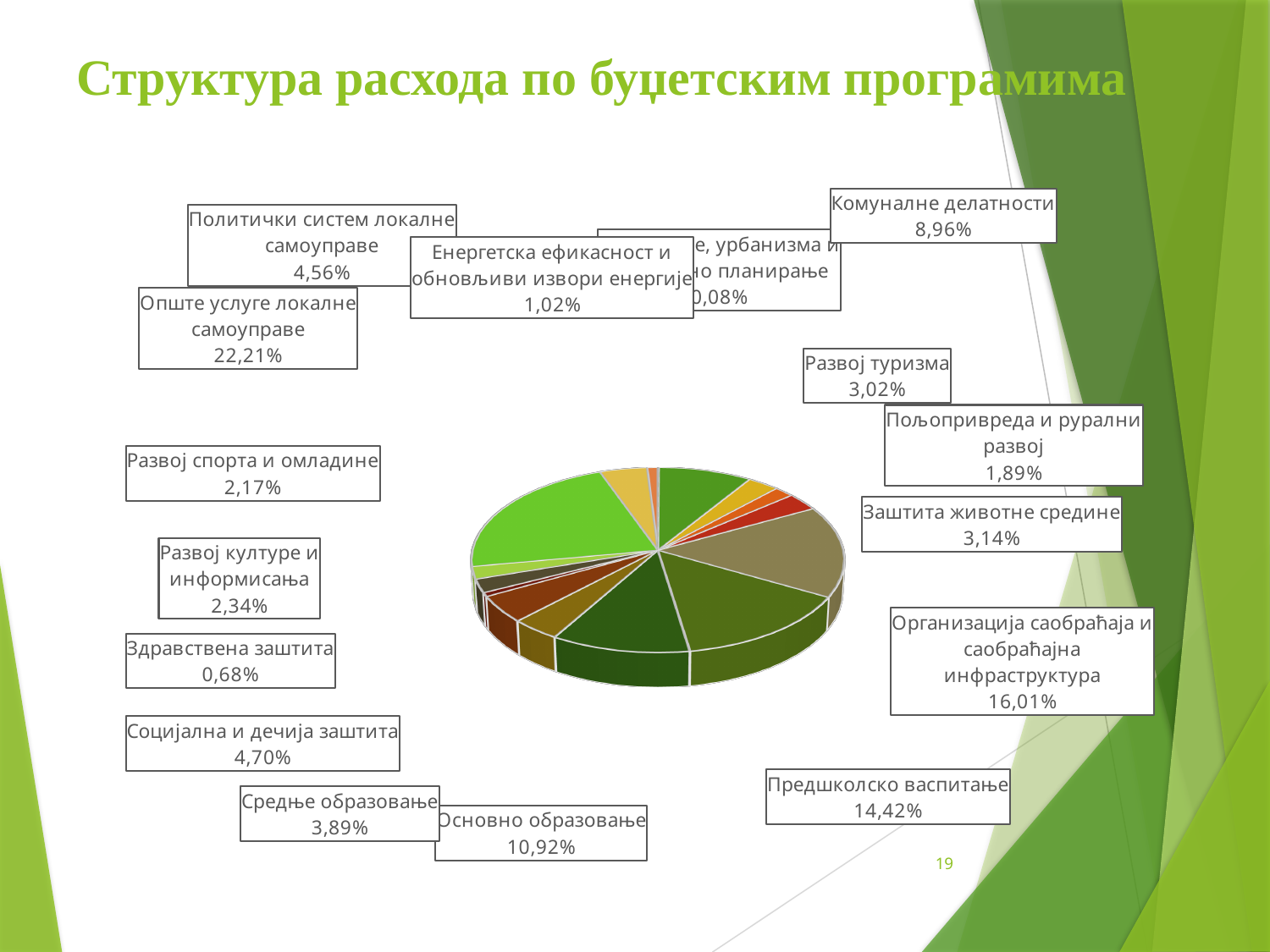
What is the difference in percentage points between Опште услуге локалне самоуправе and Организација саобраћаја и саобраћајна инфраструктура? 6,20% What is the value shown for Предшколско васпитање? 14,42% What kind of chart is shown on the slide? Pie chart What is the title of the chart on the slide? Структура расхода по буџетским програмима What percentage is shown for Организација саобраћаја и саобраћајна инфраструктура? 16,01% Which is larger, the share for Развој туризма or for Заштита животне средине? Заштита животне средине What is the difference between the shares for Предшколско васпитање and Основно образовање? 3,50% What share of expenditure goes to Опште услуге локалне самоуправе? 22,21% Which budget programme has the largest share of expenditure? Опште услуге локалне самоуправе Which is larger, the share for Предшколско васпитање or for Основно образовање? Предшколско васпитање What share is shown for Комуналне делатности? 8,96% What is the value for Здравствена заштита? 0,68%